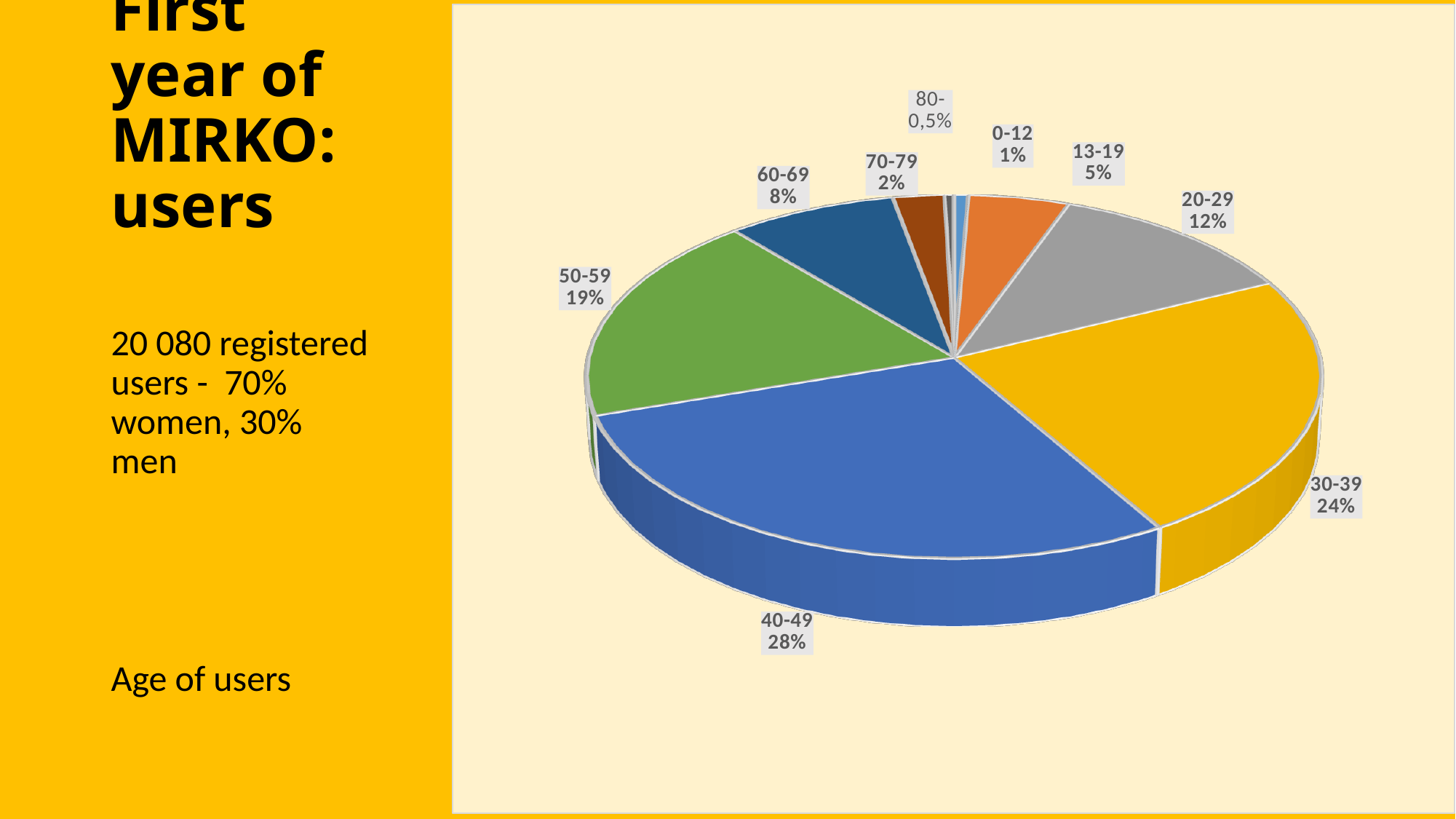
What kind of chart is shown on the slide? pie chart What colour is the slice for the 50-59 age group? green Which age group has the largest share of users? 40-49 What share of users are aged 13-19? 5% What share of users are aged 30-39? 24% What share of users are aged 40-49? 28% What is the difference in percentage points between the 40-49 and 30-39 age groups? 4 What share of users are aged 80 or over? 0,5% What share of users are aged 50-59? 19% Which age group has a larger share, 20-29 or 60-69? 20-29 How many age groups are shown in the pie chart? 9 Which age group has the smallest share of users? 80-